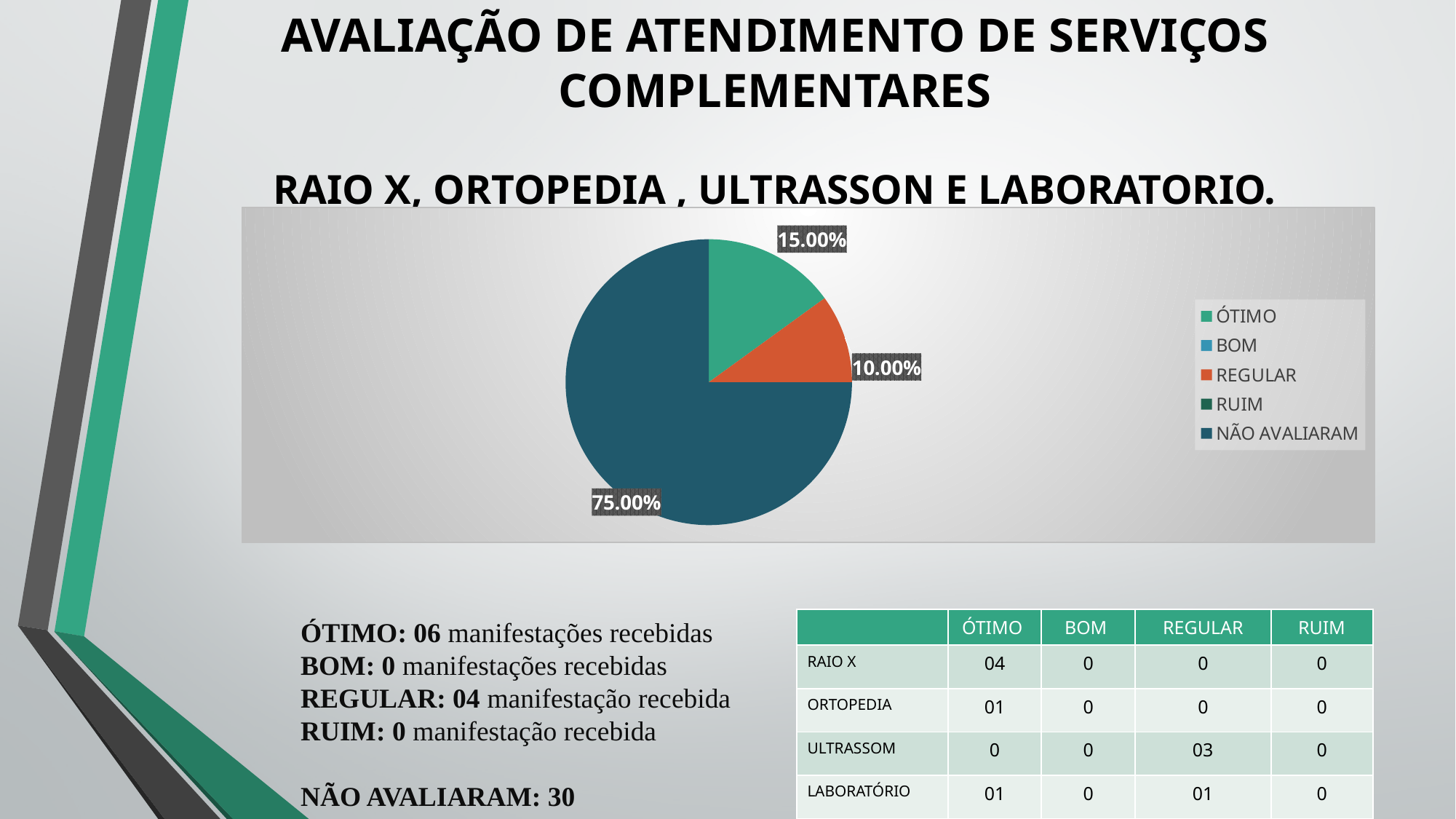
What is the difference in percentage points between the ÓTIMO slice and the REGULAR slice? 5.00% What percentage of the pie chart is labelled for NÃO AVALIARAM? 75.00% What percentage of the pie chart is labelled for REGULAR? 10.00% What percentage of the pie chart is labelled for ÓTIMO? 15.00% What kind of chart is shown on the slide? pie chart What is the difference in percentage points between the NÃO AVALIARAM slice and the ÓTIMO slice? 60.00% How many slices with percentage labels are visible in the pie chart? 3 How many entries does the legend of the pie chart list? 5 Which legend entry is shown in orange in the pie chart? REGULAR What colour is the NÃO AVALIARAM slice in the pie chart? dark teal Which category has the largest slice of the pie chart? NÃO AVALIARAM Which of the two labelled slices is larger, ÓTIMO or REGULAR? ÓTIMO